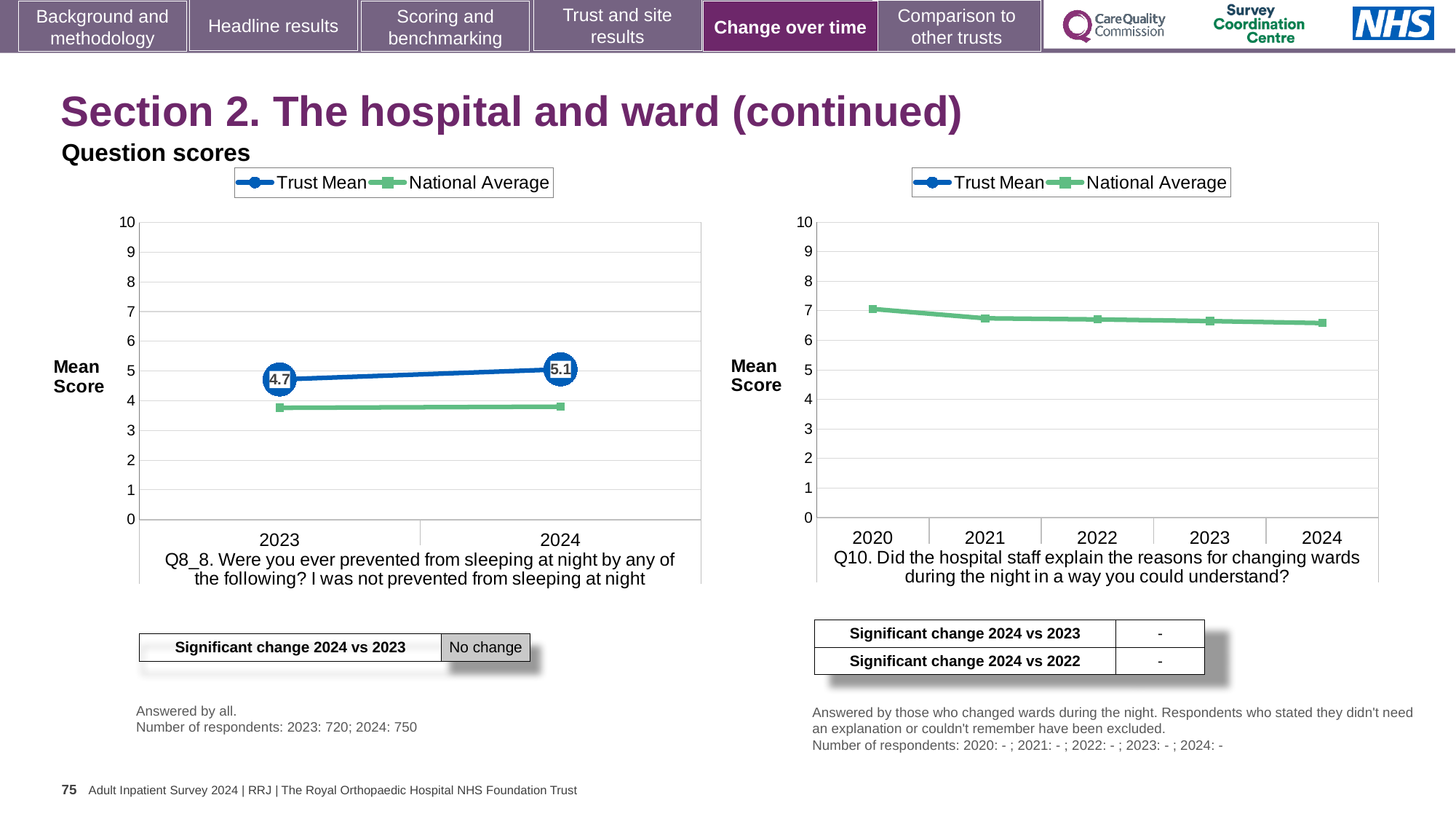
In the Q8_8 chart on the left, what is the Trust Mean score for 2024? 5.1 How many series does the legend of the Q8_8 chart on the left list? 2 How many years are shown on the x axis of the Q10 chart on the right? 5 In the Q8_8 chart on the left, which series is higher in 2023, Trust Mean or National Average? Trust Mean In the Q8_8 chart on the left, which year has the higher Trust Mean, 2023 or 2024? 2024 In the Q8_8 chart on the left, does the Trust Mean rise or fall from 2023 to 2024? rise In the Q8_8 chart on the left, by how much did the Trust Mean change from 2023 to 2024? 0.4 In the Q10 chart on the right, is the National Average for 2020 greater or less than 6? greater In the Q8_8 chart on the left, what is the Trust Mean score for 2023? 4.7 In the Q10 chart on the right, does the National Average rise or fall from 2020 to 2024? fall In the Q8_8 chart on the left, is the National Average for 2024 greater or less than 4? less What type of chart is the Q10 chart on the right? line chart